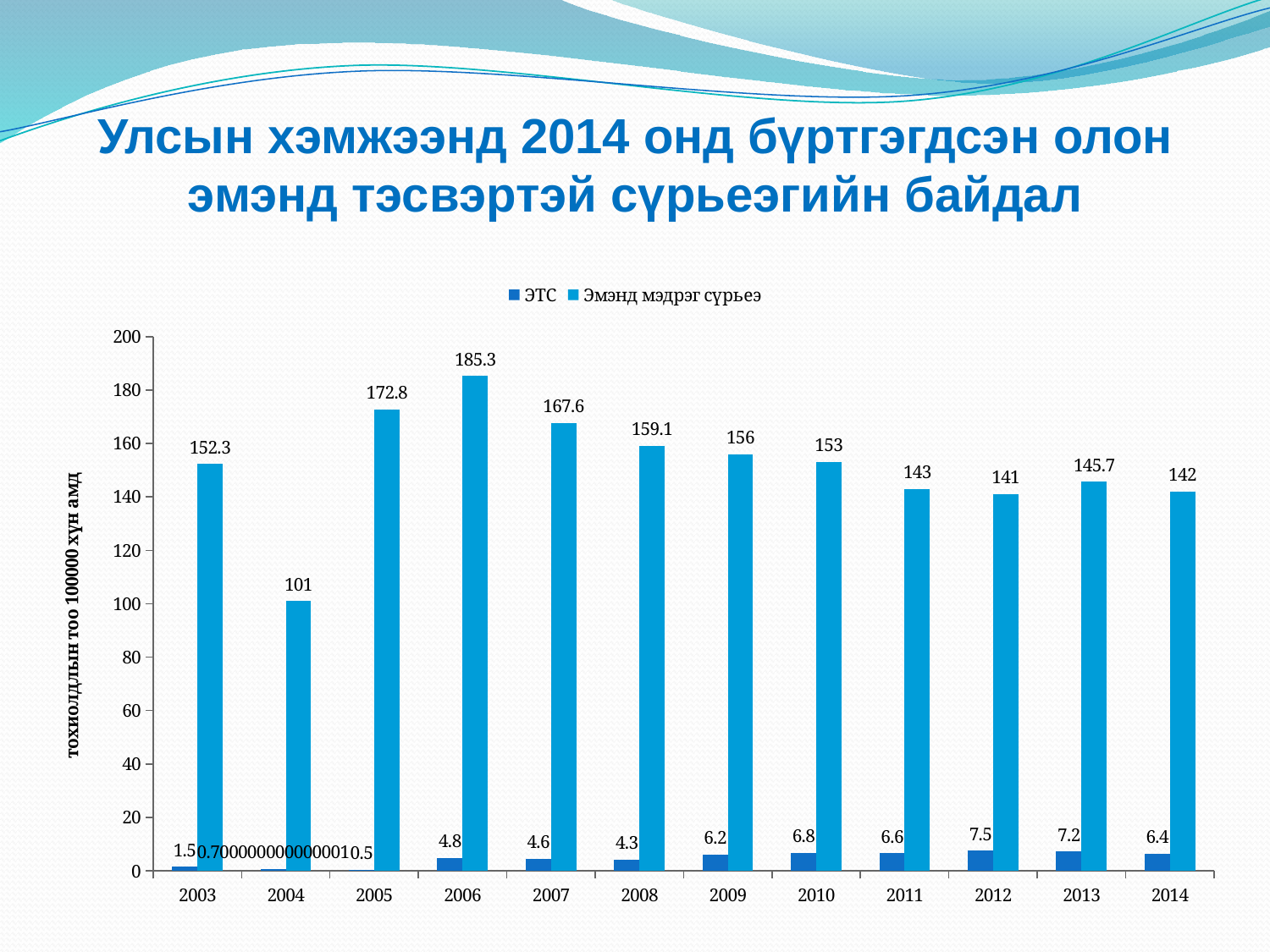
What kind of chart is shown on the slide? bar chart What is the value for Эмэнд мэдрэг сүрьеэ in 2014? 142 What is the value for ЭТС in 2012? 7.5 What is the difference between the Эмэнд мэдрэг сүрьеэ values for 2005 and 2006? 12.5 Which year has the lowest value for Эмэнд мэдрэг сүрьеэ? 2004 Is the value for Эмэнд мэдрэг сүрьеэ in 2004 greater or less than 120? less Which year has the highest value for ЭТС? 2012 How many series does the legend list? 2 Which is larger, the Эмэнд мэдрэг сүрьеэ value for 2011 or for 2013? 2013 What is the value for Эмэнд мэдрэг сүрьеэ in 2006? 185.3 Which year has the highest value for Эмэнд мэдрэг сүрьеэ? 2006 How many years are shown on the x axis? 12